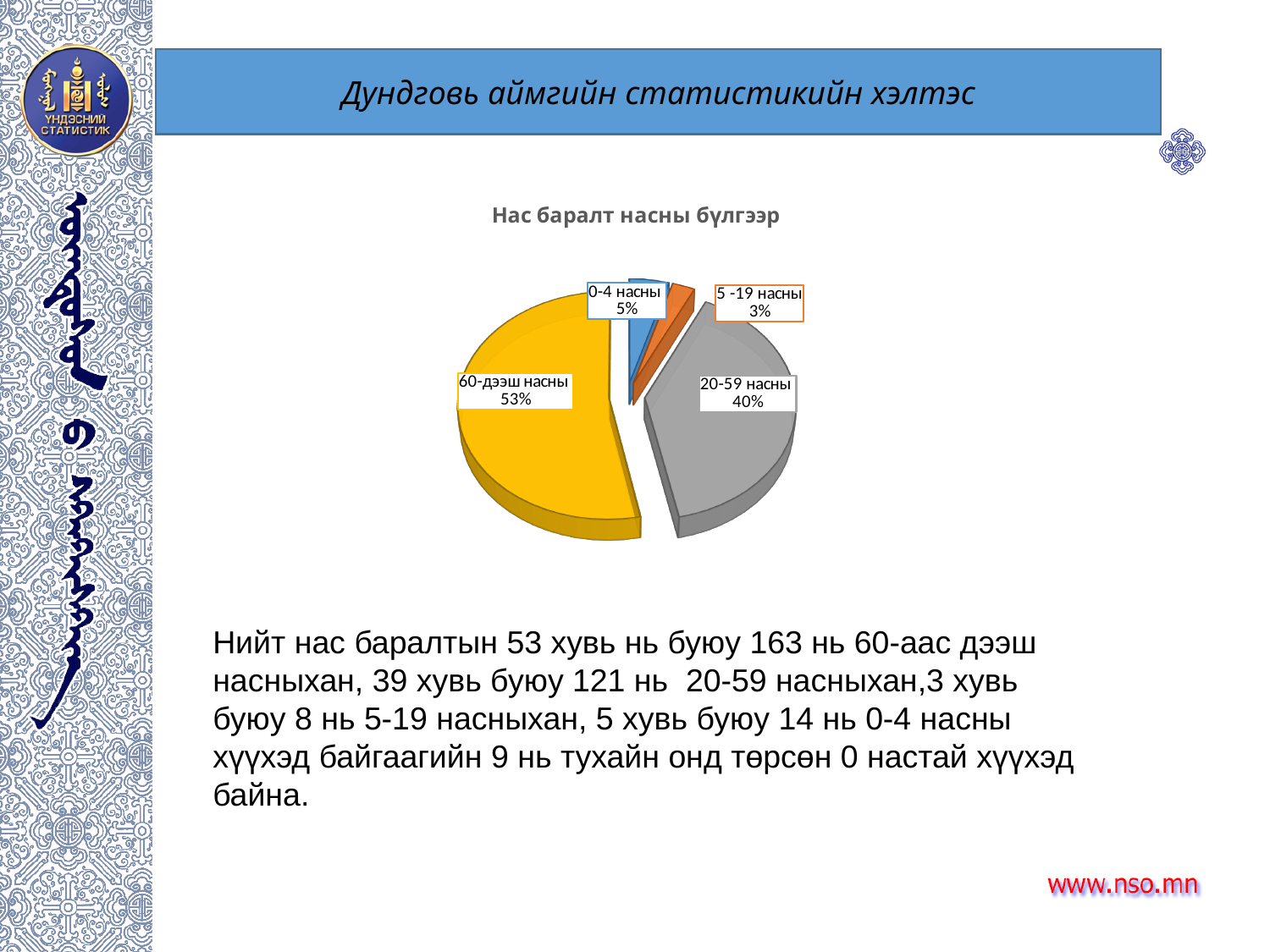
What share of the pie does the "20-59 насны" slice represent? 40% What colour is the "60-дээш насны" slice? yellow What type of chart is shown on the slide? pie chart Which is larger, the "0-4 насны" slice or the "5 -19 насны" slice? 0-4 насны How many slices does the pie chart have? 4 What is the title of the chart? Нас баралт насны бүлгээр Which age group has the smallest slice of the pie? 5 -19 насны What share of the pie does the "60-дээш насны" slice represent? 53% What is the value shown for "5 -19 насны"? 3% What is the difference in percentage points between the "60-дээш насны" and "20-59 насны" slices? 13 What is the value shown for "0-4 насны"? 5% Which age group has the largest slice of the pie? 60-дээш насны